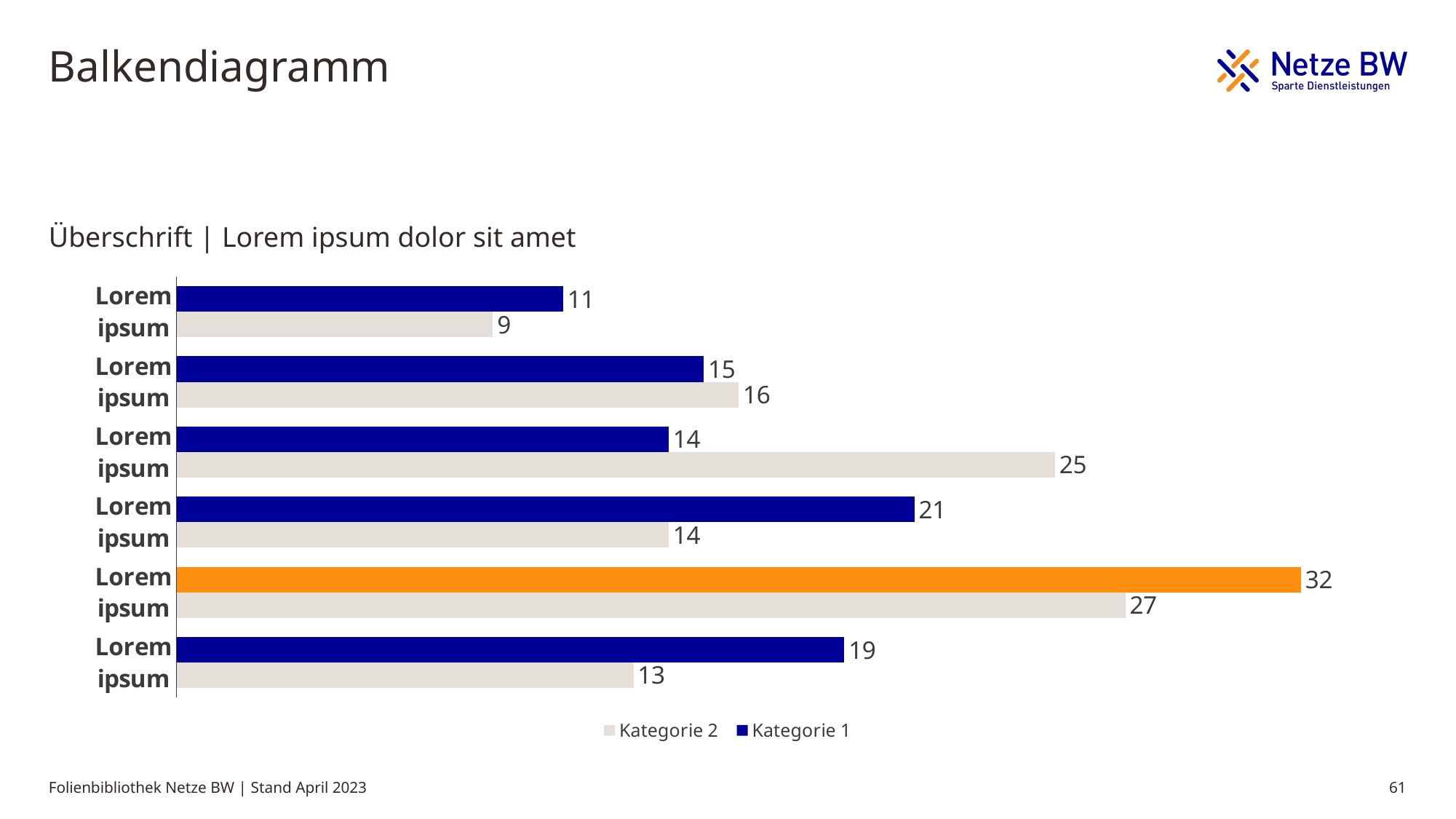
Which series has the highest value on the chart, and what is it? Kategorie 1, 32 How many series does the legend list? 2 What is the Kategorie 1 value for the topmost category? 11 Which series is shown in grey in the legend? Kategorie 2 What is the lowest value shown on the chart? 9 What is the Kategorie 2 value for the bottom category? 13 What is the difference between the Kategorie 1 and Kategorie 2 values for the fifth category from the top? 5 How many categories are plotted on the chart? 6 For the third category from the top, which is larger: Kategorie 1 or Kategorie 2? Kategorie 2 What is the value of the orange bar on the chart? 32 What kind of chart is shown on the slide? bar chart What is the Kategorie 2 value for the third category from the top? 25